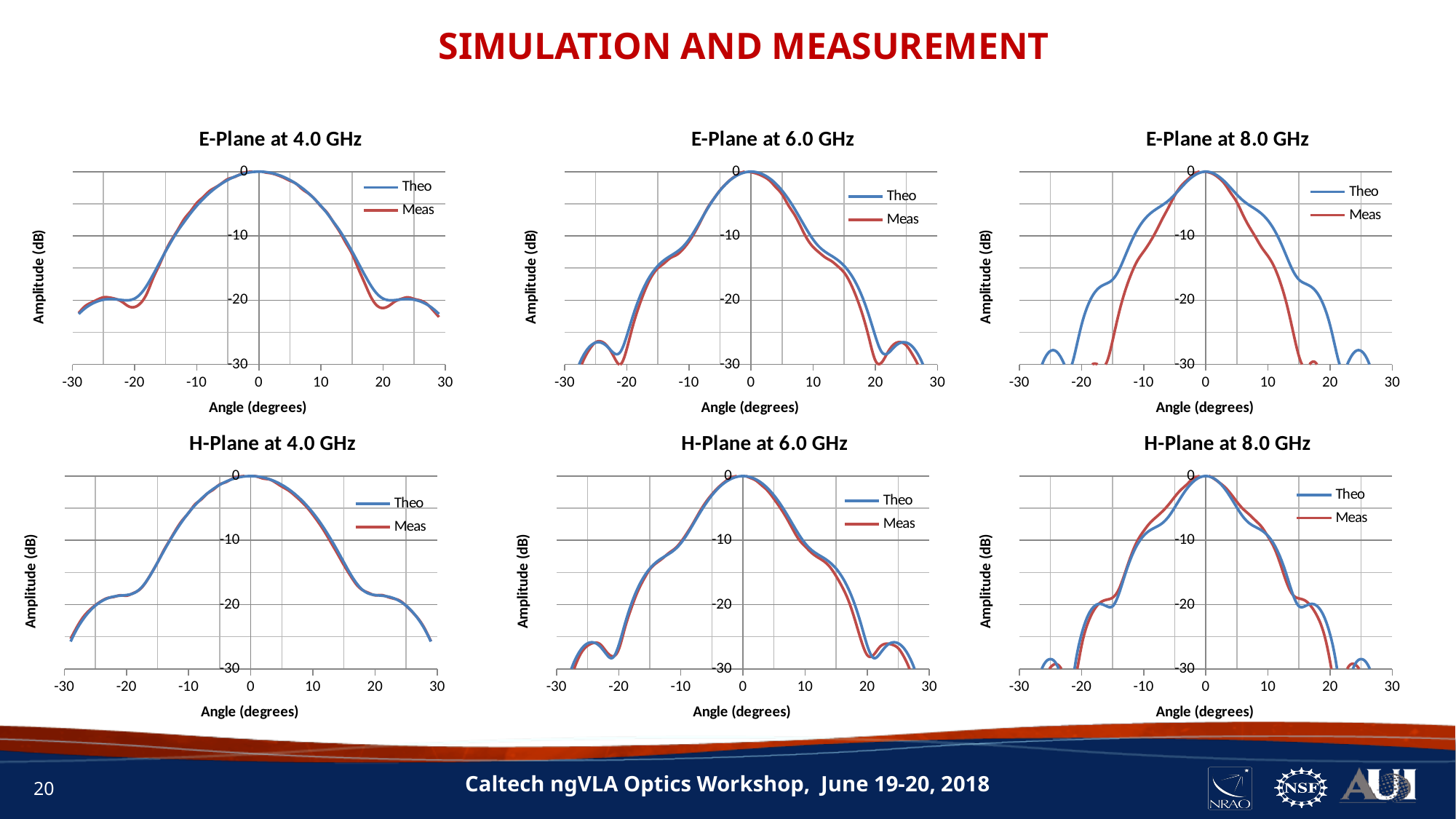
In "H-Plane at 6.0 GHz", does the Meas curve rise or fall as the angle goes from -20 to 0 degrees? rise In "E-Plane at 8.0 GHz", at 10 degrees, which series has the larger amplitude, Theo or Meas? Theo What are the two legend entries in the "E-Plane at 6.0 GHz" chart? Theo and Meas In "E-Plane at 8.0 GHz", is the Meas value at 15 degrees greater or less than -20? less How many charts are shown on the slide? 6 What is the y-axis label of the "H-Plane at 8.0 GHz" chart? Amplitude (dB) What kind of chart is "E-Plane at 4.0 GHz"? line chart In "E-Plane at 6.0 GHz", is the Theo value at -25 degrees greater or less than -20? less In "H-Plane at 4.0 GHz", does the Theo curve rise or fall as the angle goes from 0 to 30 degrees? fall In "E-Plane at 4.0 GHz", is the Meas value at 20 degrees greater or less than -10? less How many series does the legend of "H-Plane at 6.0 GHz" list? 2